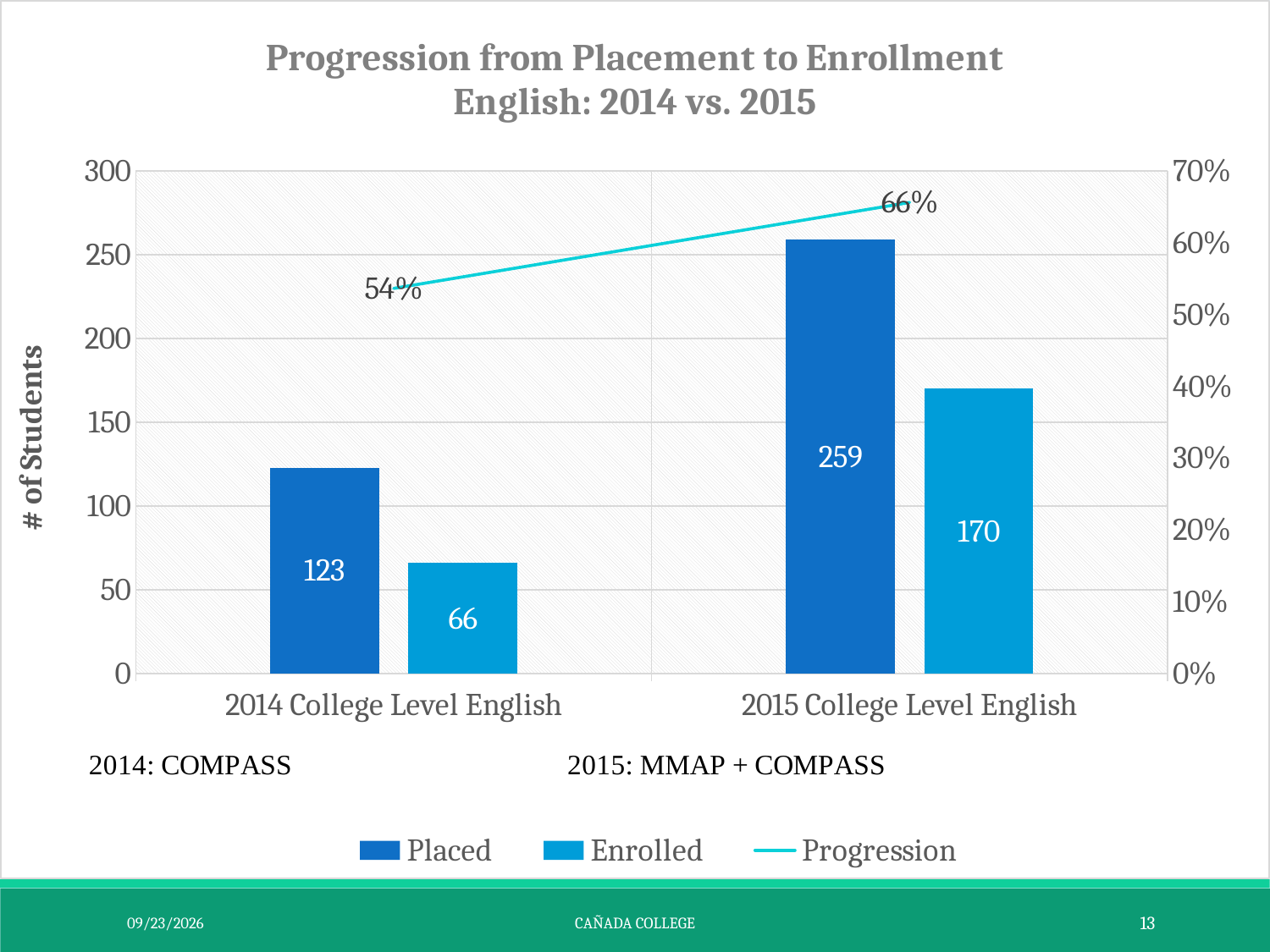
How many students were Placed in 2014 College Level English? 123 By how many students did the Placed count increase from 2014 to 2015? 136 Is the Enrolled value for 2014 College Level English greater or less than 100? less What is the Progression percentage for 2015 College Level English? 66% Does the Progression line rise or fall from 2014 to 2015? rise How many series does the legend list? 3 Which category has the lowest Enrolled value? 2014 College Level English How many students were Enrolled in 2015 College Level English? 170 What is the difference between Placed and Enrolled students in 2015 College Level English? 89 Which category has the higher number of Placed students? 2015 College Level English What is the Progression percentage for 2014 College Level English? 54% What is the label of the left vertical axis? # of Students